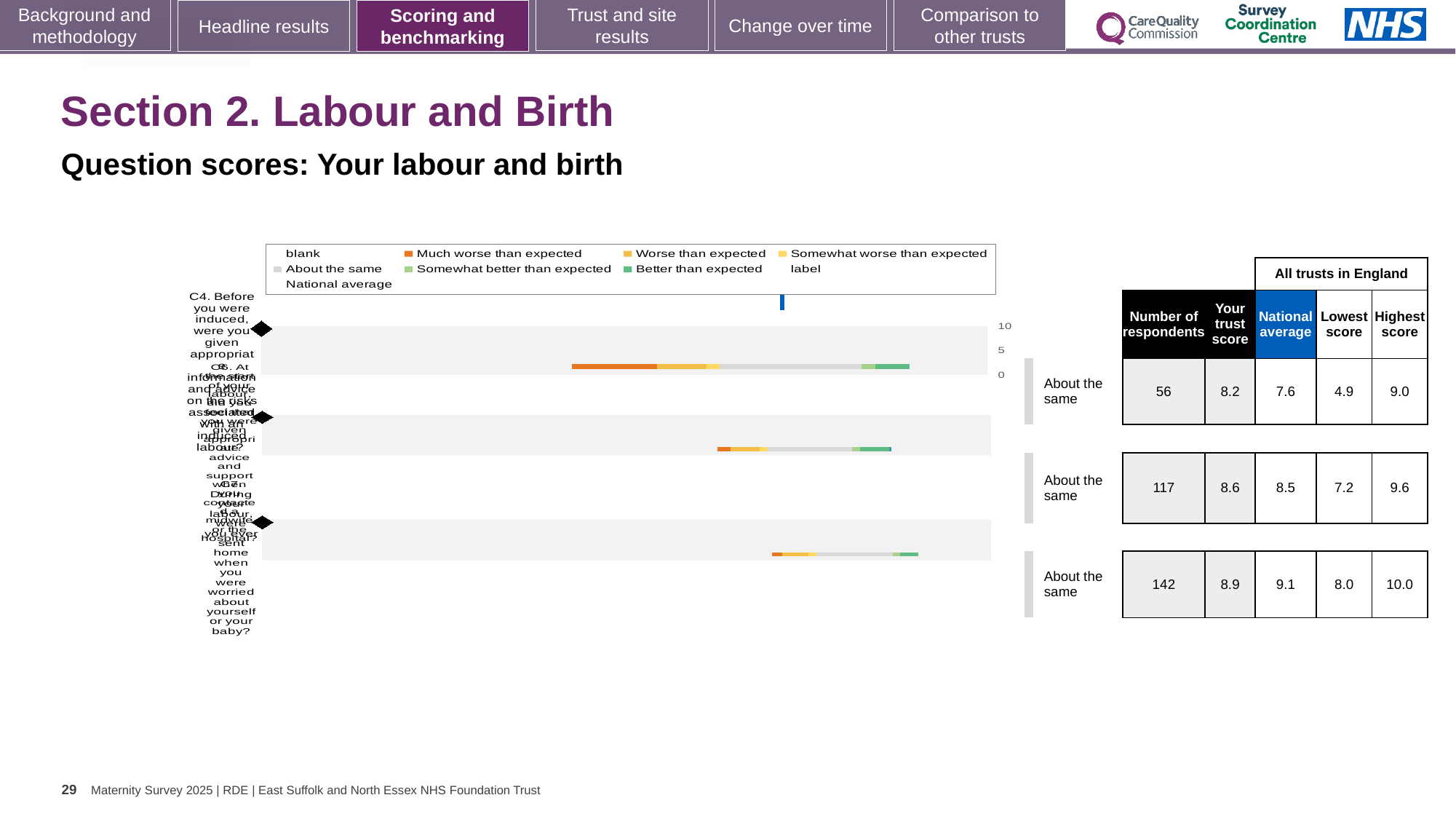
What is the highest score among all trusts in England for the third (bottom) row? 10.0 For the first (top) row, what is the difference between the highest score and the lowest score across all trusts in England? 4.1 For the first (top) row, which is larger: the trust score or the national average? the trust score (8.2) What is the 'Your trust score' for the first (top) row, C4 about information and advice before induction? 8.2 What kind of chart is shown on the slide? bar chart What is the number of respondents for the third (bottom) row of the chart? 142 What benchmark category is shown next to each of the three bars in the chart? About the same Which row has the highest number of respondents? the third (bottom) row, 142 What is the number of respondents for the first (top) row of the chart? 56 How many question rows (bars) are plotted in the chart? 3 What is the highest tick value shown on the chart's axis? 10 What is the national average for the second (middle) row of the chart? 8.5